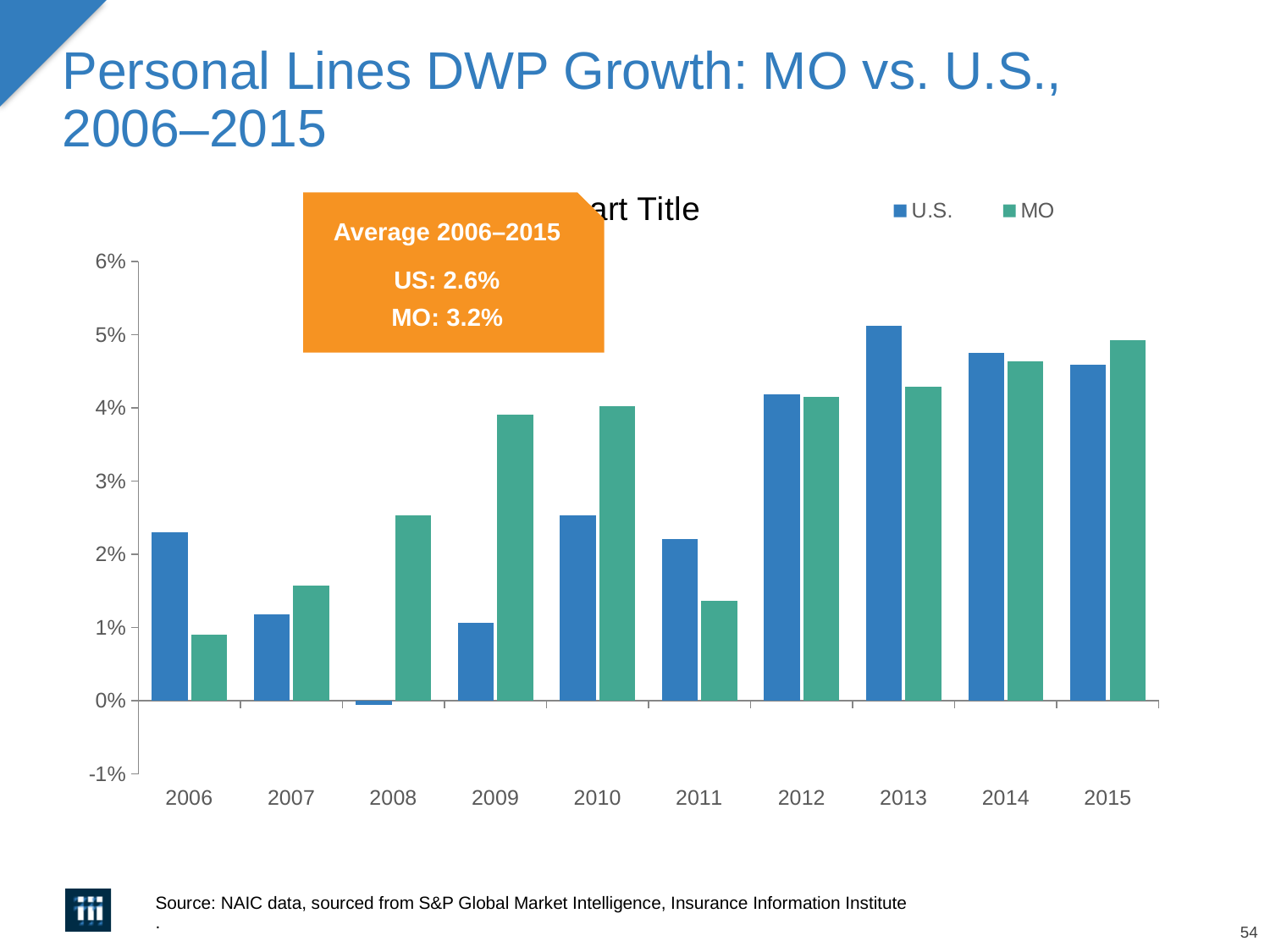
In which year is the U.S. value lowest? 2008 In which year is the U.S. value highest? 2013 How many series does the legend list? 2 In 2009, which is larger, the U.S. value or the MO value? MO In which year is the MO value highest? 2015 In which year is the MO value lowest? 2006 According to the callout box, what is the U.S. average for 2006–2015? 2.6% According to the callout box, what is the MO average for 2006–2015? 3.2% What kind of chart is shown on the slide? bar chart Is the U.S. value for 2013 greater or less than 5%? greater Is the MO value for 2008 greater or less than 2%? greater How many years are shown on the x axis? 10